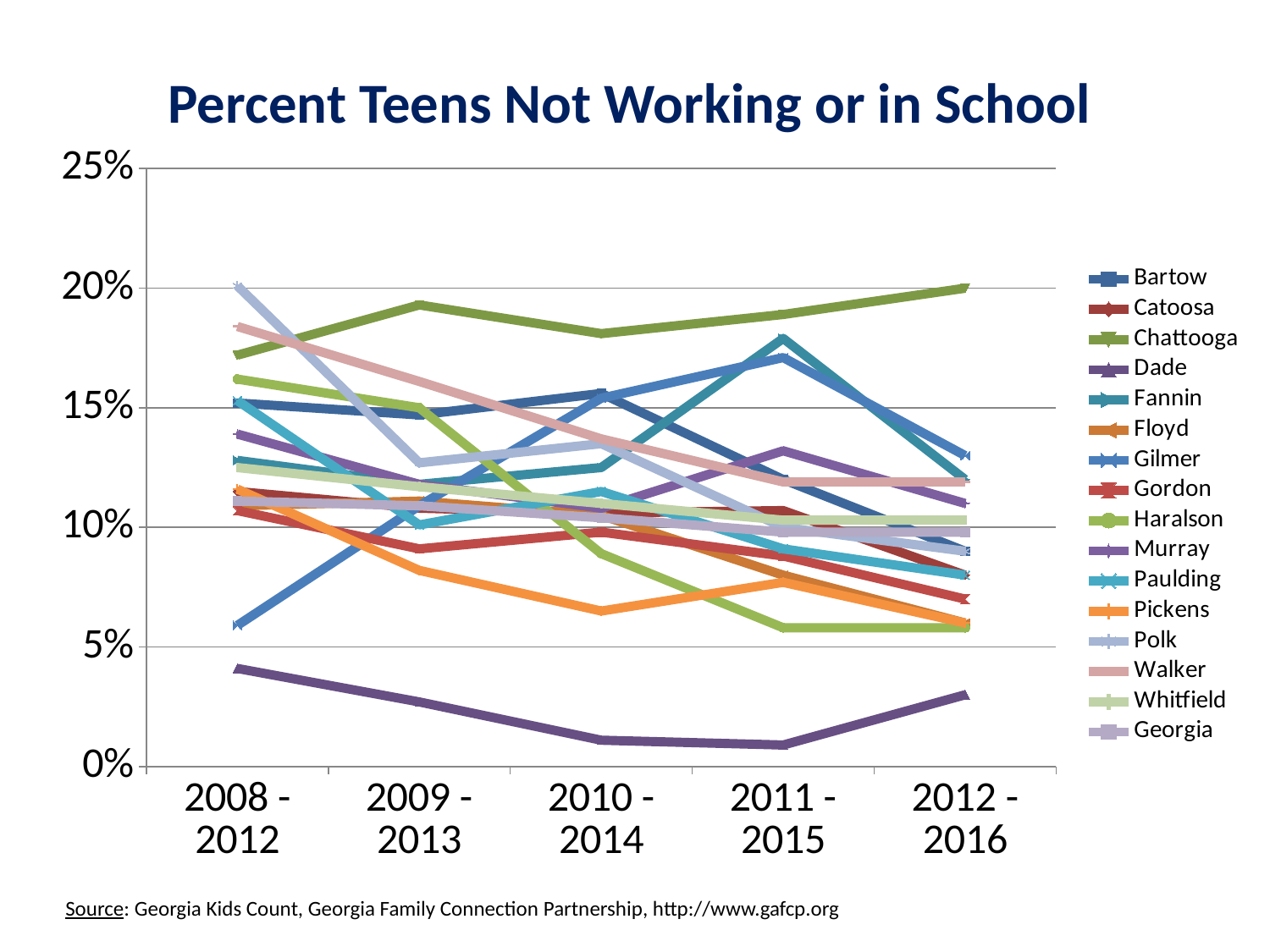
What kind of chart is shown on the slide? Line chart How many series does the legend list? 16 Does the value for Chattooga rise or fall from 2008 - 2012 to 2012 - 2016? Rise Which county has the highest value in the 2012 - 2016 period? Chattooga Is the value for Chattooga in 2012 - 2016 greater or less than 15%? greater What is the title of the chart? Percent Teens Not Working or in School Which county has the lowest value in the 2012 - 2016 period? Dade In the 2008 - 2012 period, which is larger, the value for Polk or the value for Gilmer? Polk How many time periods are shown on the x axis? 5 Is the value for Dade in 2010 - 2014 greater or less than 5%? less Is the value for Gilmer in 2008 - 2012 greater or less than 10%? less Which county has the lowest value in the 2008 - 2012 period? Dade